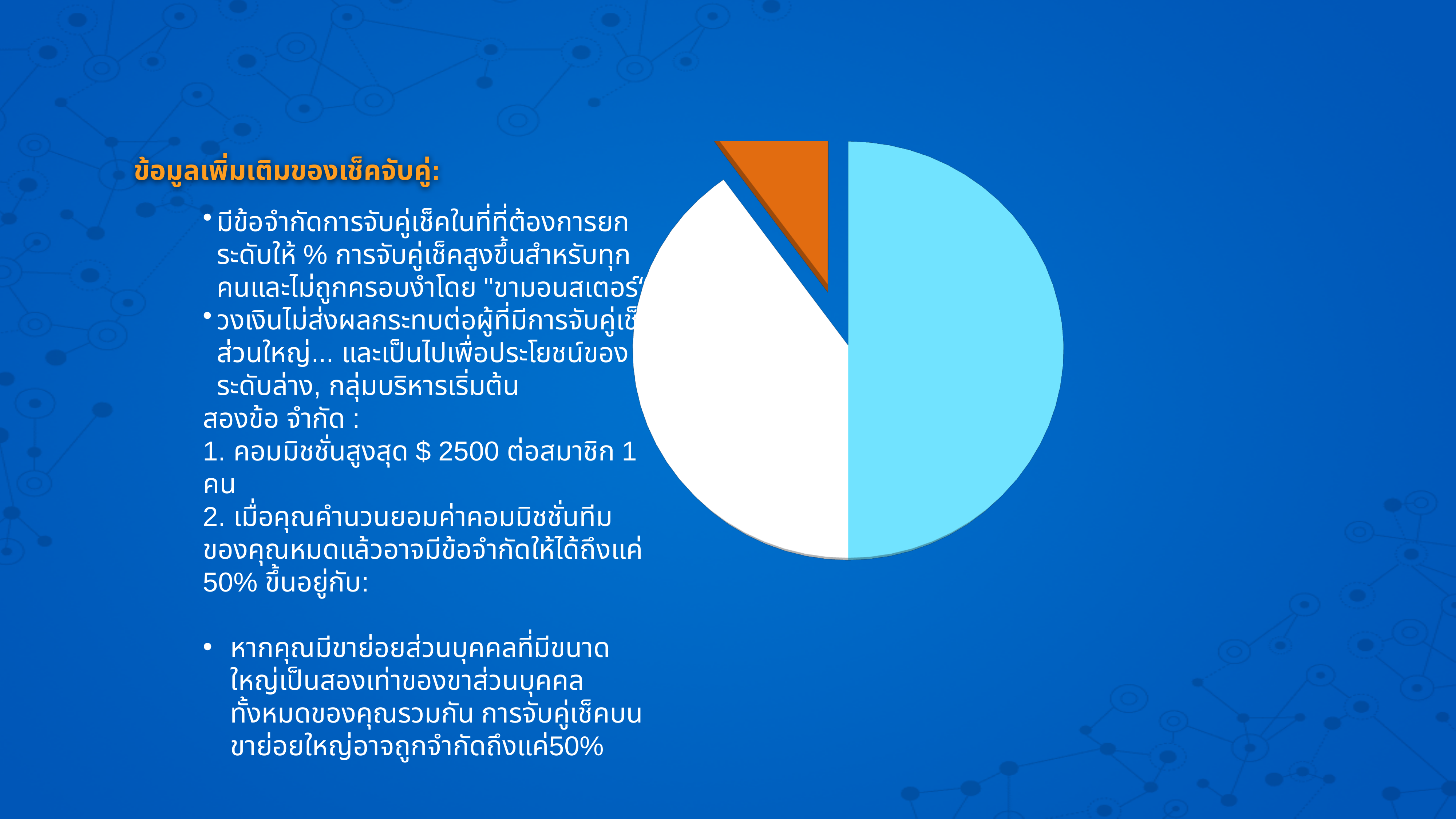
Which slice of the pie chart is the smallest? the orange slice Does the pie chart have a legend? No What colours are the three slices of the pie chart? light blue, white and orange What kind of chart is shown on the slide? pie chart Which is larger in the pie chart, the white slice or the orange slice? the white slice Which is larger in the pie chart, the light blue slice or the white slice? the light blue slice How many slices does the pie chart have? 3 Which slice of the pie chart is the largest? the light blue slice